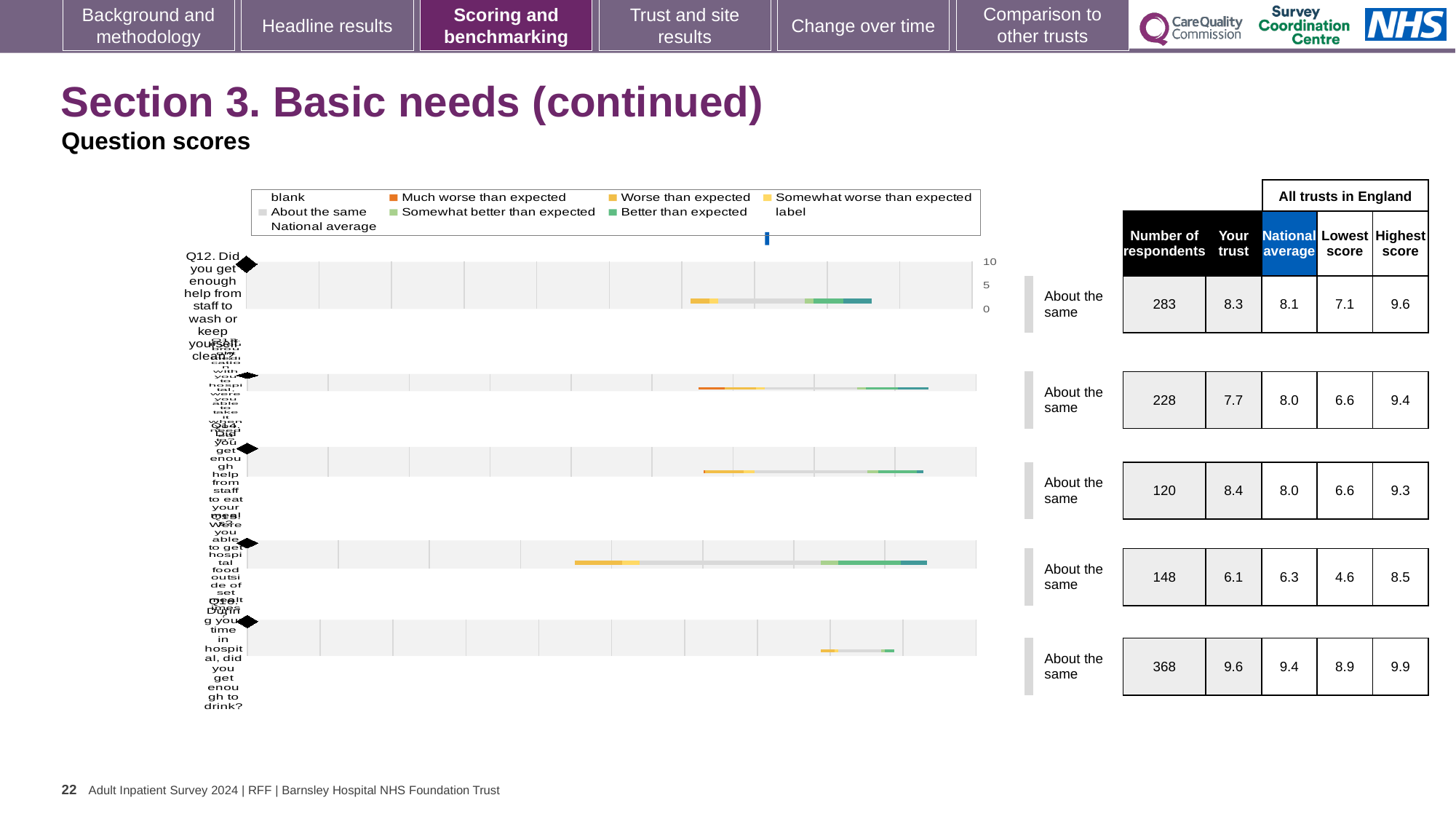
How many question rows are plotted in the chart? 5 What benchmark category is shown for Q12 (help from staff to wash or keep yourself clean)? About the same What kind of chart is used to show the question scores on this slide? bar chart What is the 'Your trust' score for Q12 (help from staff to wash or keep yourself clean)? 8.3 In the chart legend, which colour represents 'Much worse than expected'? orange Which row in the table has the lowest 'Your trust' score? the fourth row (6.1) What is the national average for Q12 (help from staff to wash or keep yourself clean)? 8.1 What is the number of respondents shown in the bottom row of the table? 368 Which row in the table has the highest 'Your trust' score? the bottom row (9.6) Which is larger for Q12: the 'Your trust' score or the national average? Your trust What is the difference between the highest score (9.6) and the lowest score (7.1) for Q12? 2.5 What is the number of respondents for Q12 (help from staff to wash or keep yourself clean)? 283